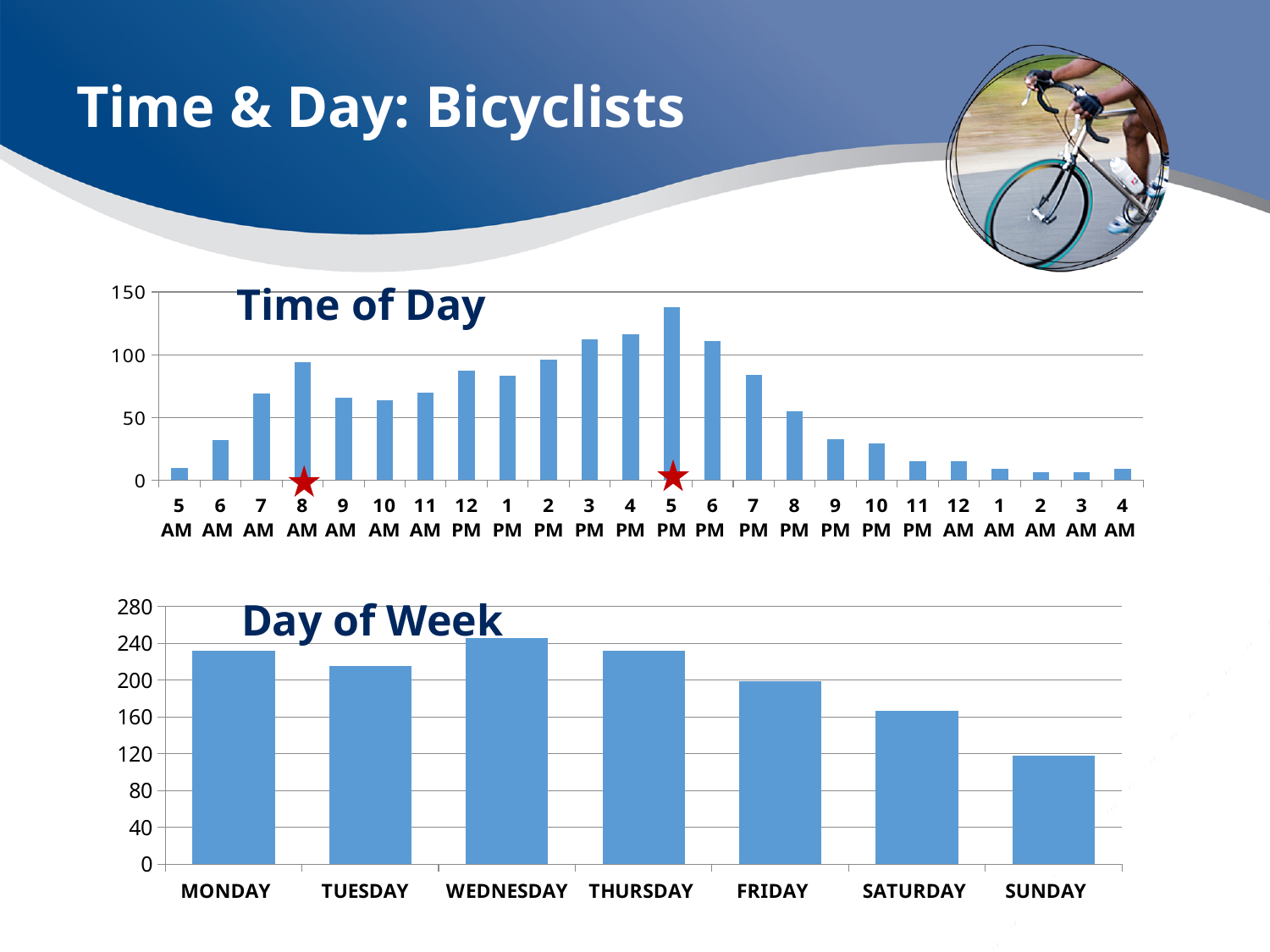
In the Day of Week chart, is the value for Sunday greater or less than 160? less In the Time of Day chart, is the value for 8 AM greater or less than 50? greater In the Day of Week chart, which day has the lowest value? Sunday In the Day of Week chart, do the values rise or fall from Wednesday to Sunday? fall In the Time of Day chart, is the value for 9 PM greater or less than 50? less In the Day of Week chart, which is larger, the value for Tuesday or the value for Friday? Tuesday What kind of chart is the Time of Day chart? bar chart In the Day of Week chart, which day has the highest value? Wednesday How many days are shown in the Day of Week chart? 7 In the Time of Day chart, which time has the highest value? 5 PM